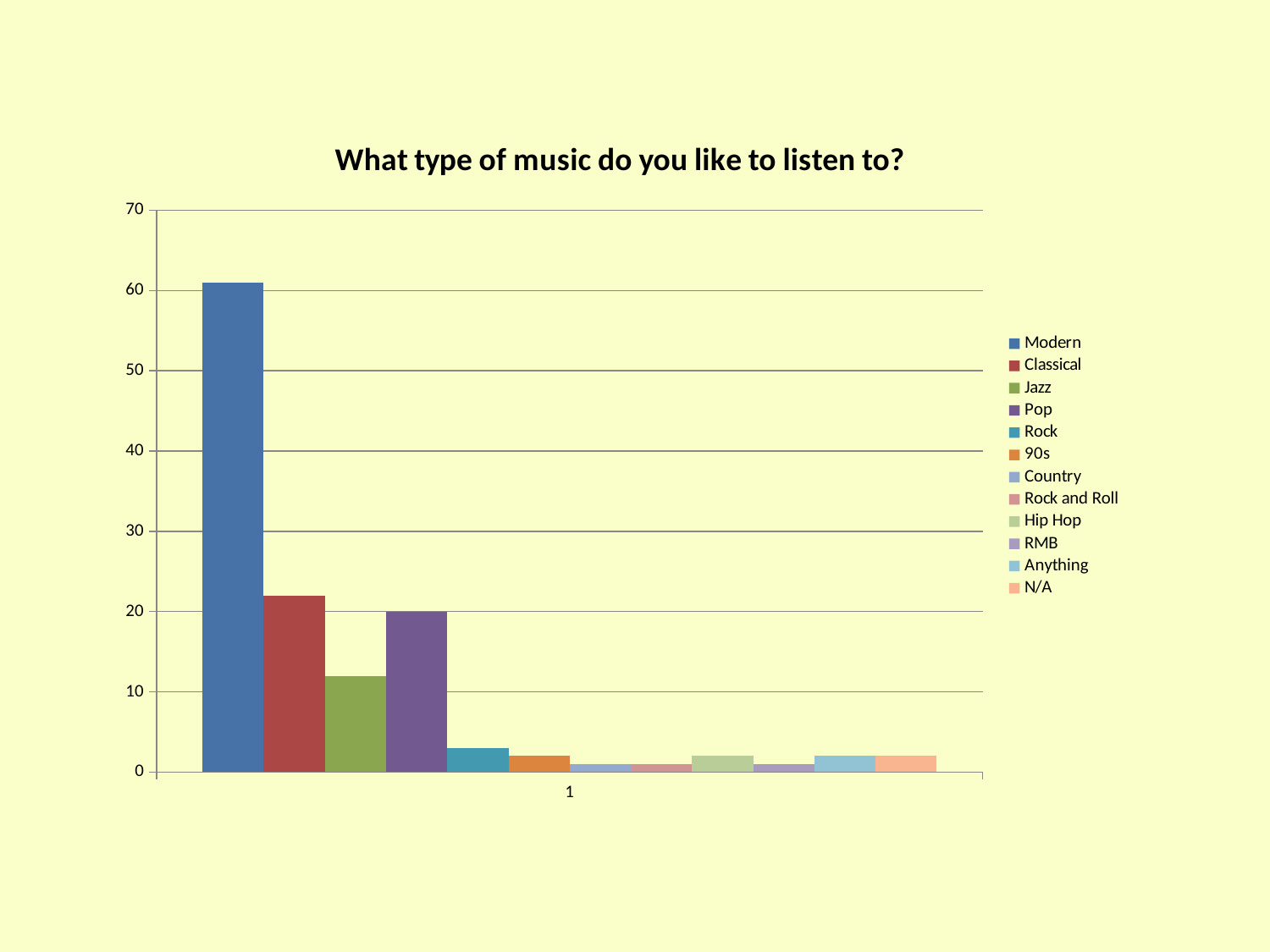
Which is larger, the value for Jazz or the value for Pop? Pop Which legend entry is listed last? N/A Is the value for Classical greater or less than 30? less Which music type has the highest value? Modern What is the title of the chart? What type of music do you like to listen to? Is the value for Jazz greater or less than 10? greater Which is larger, the value for Modern or the value for Classical? Modern Which is larger, the value for Classical or the value for Jazz? Classical What kind of chart is shown on the slide? bar chart Is the value for Modern greater or less than 50? greater How many series does the legend list? 12